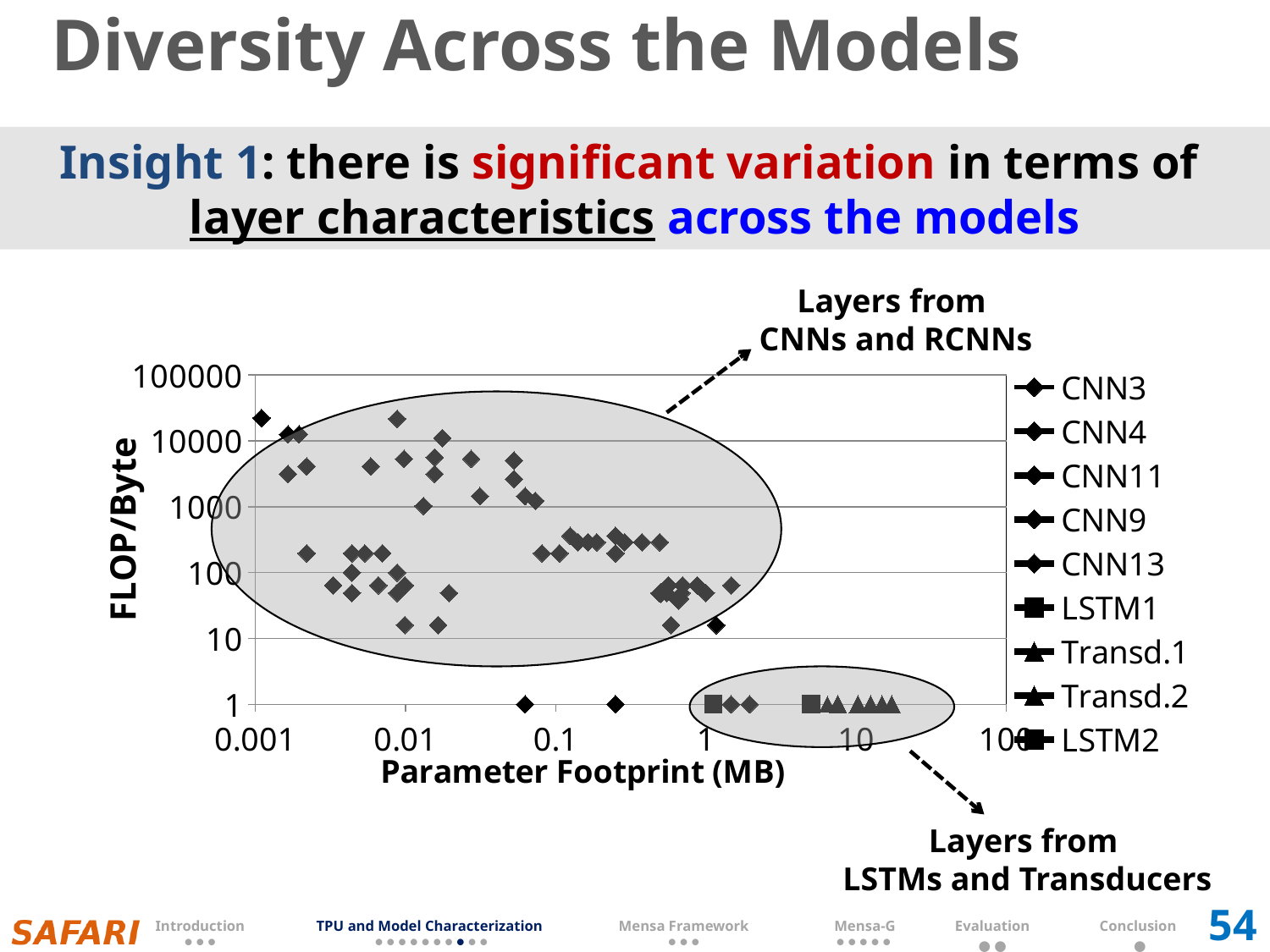
How many series does the chart legend list? 9 Are the parameter footprints of the LSTM and Transducer layers greater or less than 100 MB? less What is the lowest value shown on the x axis? 0.001 What kind of chart is shown on the slide? scatter chart At what FLOP/Byte value do the LSTM and Transducer layer points lie? 1 What is the label of the chart's y axis? FLOP/Byte What is the label of the chart's x axis? Parameter Footprint (MB) Which group of layers has higher FLOP/Byte values: the layers from CNNs and RCNNs or the layers from LSTMs and Transducers? Layers from CNNs and RCNNs Are the parameter footprints of the Transd.1 and Transd.2 layers greater or less than 1 MB? greater